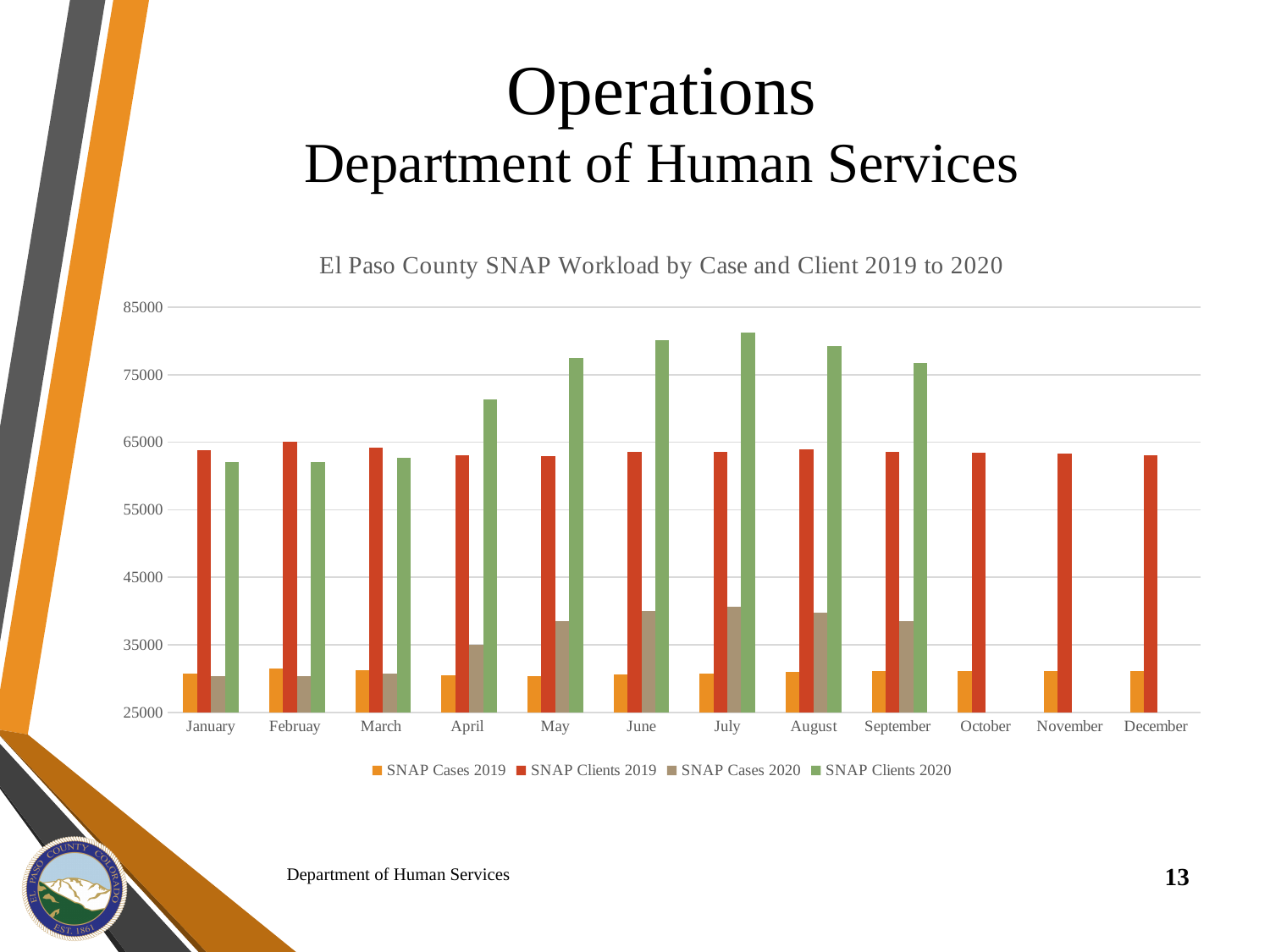
Which series is shown in green? SNAP Clients 2020 Is the value for SNAP Clients 2020 in January greater or less than 65000? less In which month is SNAP Clients 2019 highest? February What is the title of the chart? El Paso County SNAP Workload by Case and Client 2019 to 2020 What kind of chart is shown on the slide? bar chart Do the SNAP Clients 2020 values rise or fall from March to July? rise How many series does the legend list? 4 Is the value for SNAP Cases 2019 in January greater or less than 35000? less Is the value for SNAP Cases 2020 in June greater or less than 35000? greater Which is larger in May: SNAP Clients 2019 or SNAP Clients 2020? SNAP Clients 2020 How many months are shown on the x axis? 12